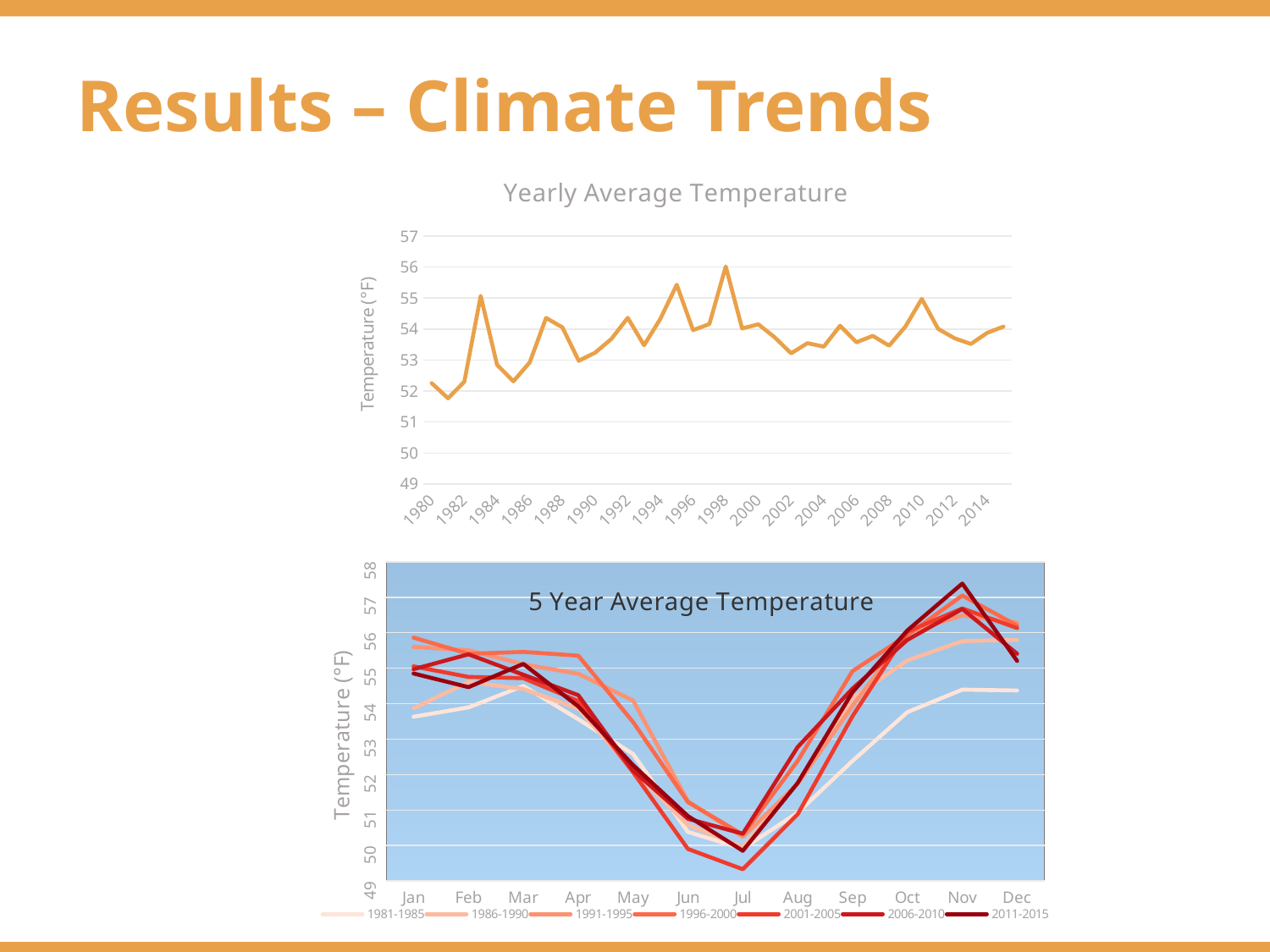
In the "Yearly Average Temperature" chart, which is higher, the value for 1998 or the value for 2002? 1998 How many months are shown on the x axis of the "5 Year Average Temperature" chart? 12 In the "5 Year Average Temperature" chart, do the values fall or rise from Jan to Jul? fall In the "Yearly Average Temperature" chart, is the value for 2010 greater or less than 54? greater In the "Yearly Average Temperature" chart, is the value for 1998 greater or less than 55? greater In the "5 Year Average Temperature" chart, is the value for 2011-2015 in Nov greater or less than 57? greater What kind of chart is the "Yearly Average Temperature" chart? line chart How many series does the legend of the "5 Year Average Temperature" chart list? 7 In the "Yearly Average Temperature" chart, which year has the lowest temperature? 1981 In the "Yearly Average Temperature" chart, which year has the highest temperature? 1998 In the "5 Year Average Temperature" chart, in which month does the 2001-2005 series reach its lowest value? Jul